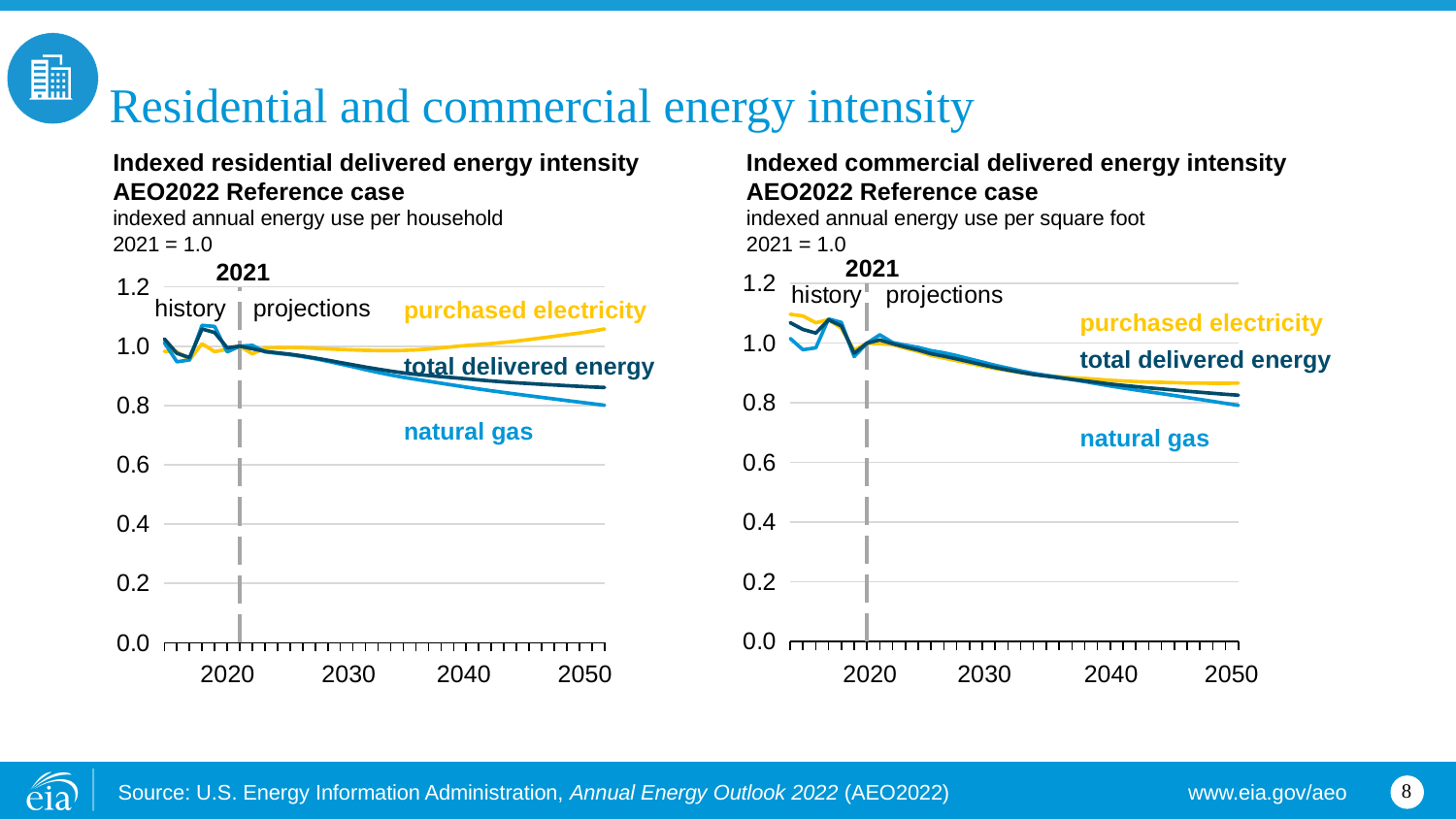
What kind of chart is the left chart, 'Indexed residential delivered energy intensity'? line chart On the left chart (residential), is the value for purchased electricity in 2050 greater or less than 1.0? greater On the right chart (commercial), is the value for purchased electricity in 2050 greater or less than 0.8? greater On the right chart (commercial), is the value for natural gas in 2050 greater or less than 1.0? less On the right chart (commercial), what is the indexed value of total delivered energy in 2021? 1.0 How many series are labelled on the right chart, 'Indexed commercial delivered energy intensity'? 3 On the left chart (residential), which series has the highest value in 2050? purchased electricity On the right chart (commercial), which series has the lowest value in 2050? natural gas On the left chart (residential), which year does the dashed vertical line separating history from projections mark? 2021 On the left chart (residential), does the natural gas series rise or fall over the projection period from 2021 to 2050? fall On the left chart (residential), what is the indexed value of every series in 2021? 1.0